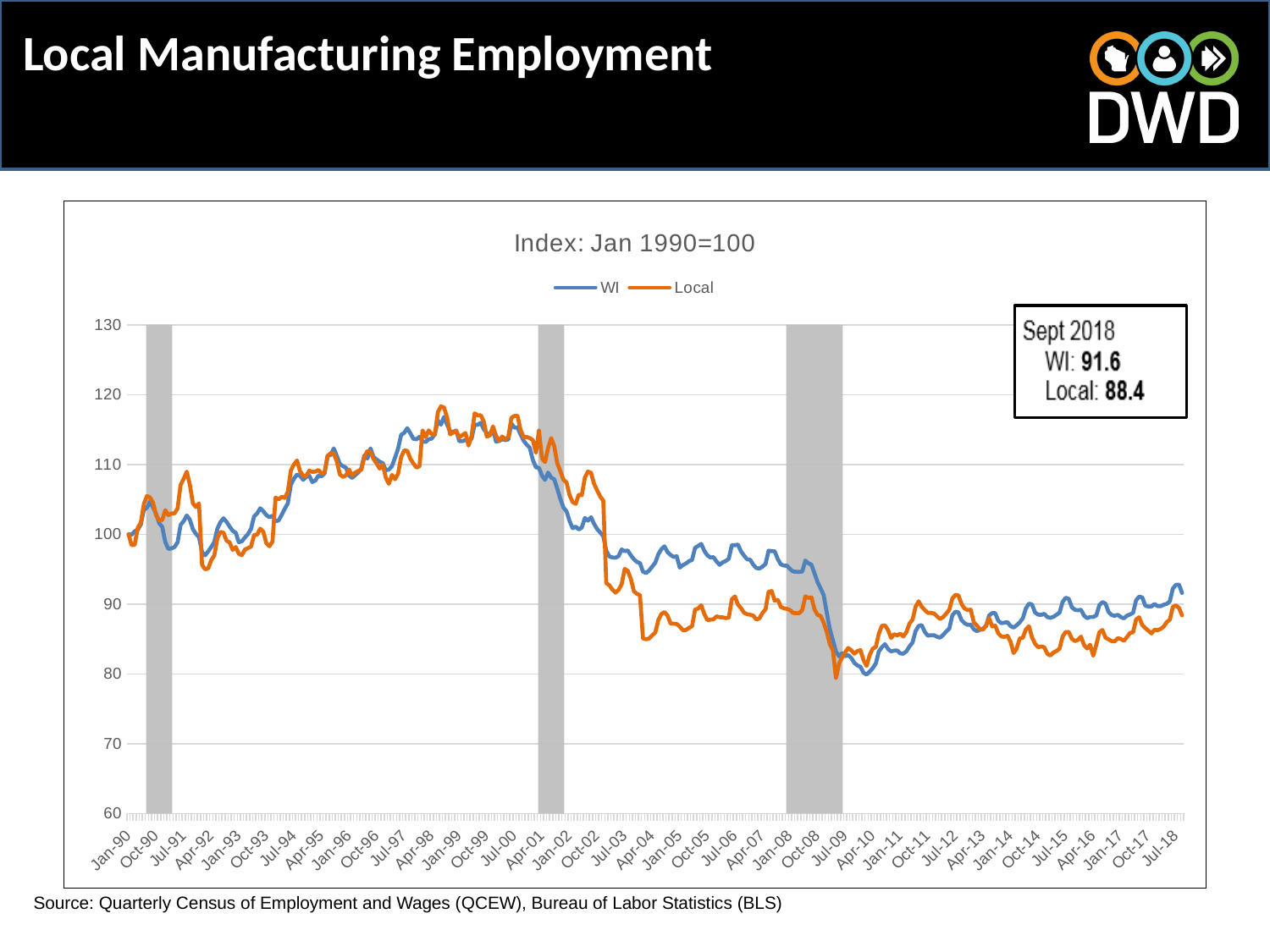
What is the Local index value for Sept 2018 shown in the annotation box? 88.4 What is the index value of both series in Jan 1990, the base period? 100 Is the WI index value around Jan-99 greater or less than 110? greater Does the WI index rise or fall between Jan-01 and Jan-10? fall What is the WI index value for Sept 2018 shown in the annotation box? 91.6 In Sept 2018, which series has the higher index value, WI or Local? WI What is the title of the chart? Index: Jan 1990=100 What is the difference between the WI and Local index values for Sept 2018? 3.2 Is the Local index value around Apr-04 greater or less than 90? less What colour is the line for the Local series? orange What kind of chart is shown on the slide? line chart How many series does the chart's legend list? 2